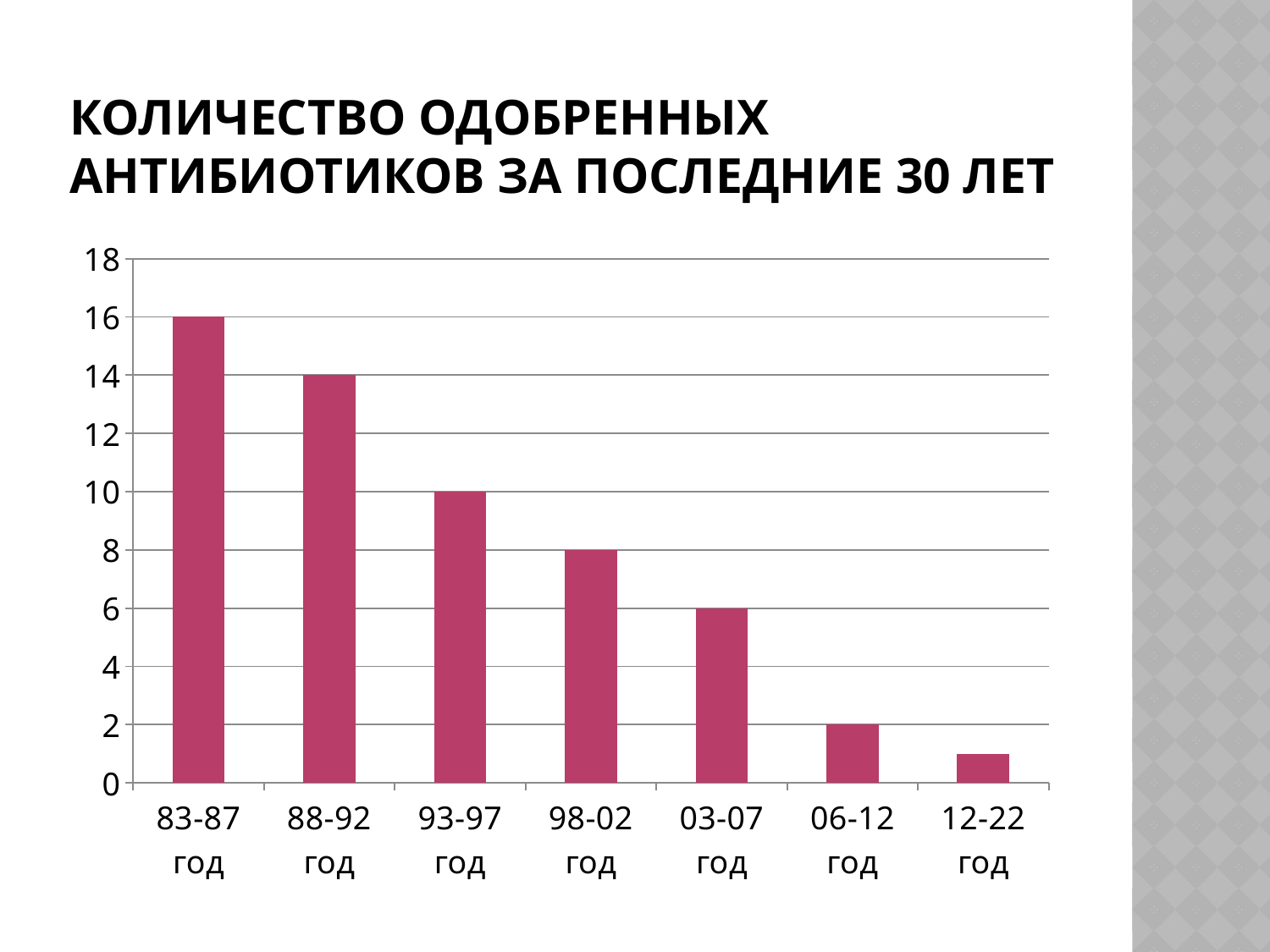
What is the value for 88-92 год? 14 How many categories (periods) are shown on the x axis? 7 Which period has the highest value? 83-87 год What is the value for 03-07 год? 6 What is the value for 83-87 год? 16 Which is larger, the value for 98-02 год or the value for 06-12 год? 98-02 год What is the value for 93-97 год? 10 Do the values rise or fall from left to right along the x axis? fall Is the value for 12-22 год greater or less than 2? less What is the difference between the values for 83-87 год and 98-02 год? 8 What type of chart is shown on the slide? bar chart Which period has the lowest value? 12-22 год